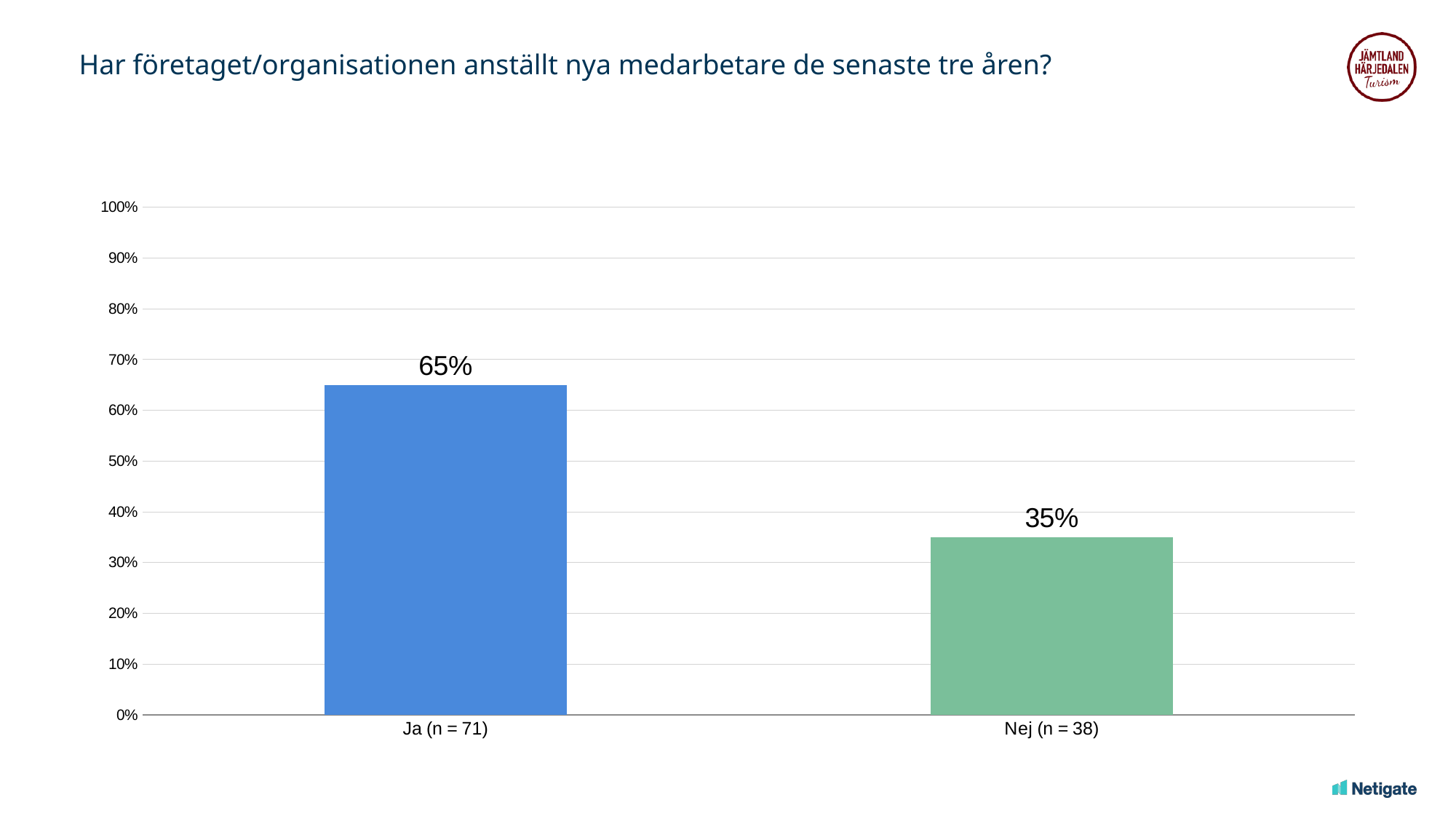
What kind of chart is shown on the slide? bar chart Is the value for "Ja (n = 71)" greater or less than 50%? greater What colour is the bar for "Nej (n = 38)"? green What is the title of the slide? Har företaget/organisationen anställt nya medarbetare de senaste tre åren? What is the value for "Nej (n = 38)"? 35% What is the value for "Ja (n = 71)"? 65% Which category has the highest value? Ja (n = 71) How many categories are shown in the chart? 2 What is the difference between the values for "Ja (n = 71)" and "Nej (n = 38)"? 30% Which category has the lowest value? Nej (n = 38) Which is larger, the value for "Ja (n = 71)" or the value for "Nej (n = 38)"? Ja (n = 71) Is the value for "Nej (n = 38)" greater or less than 40%? less